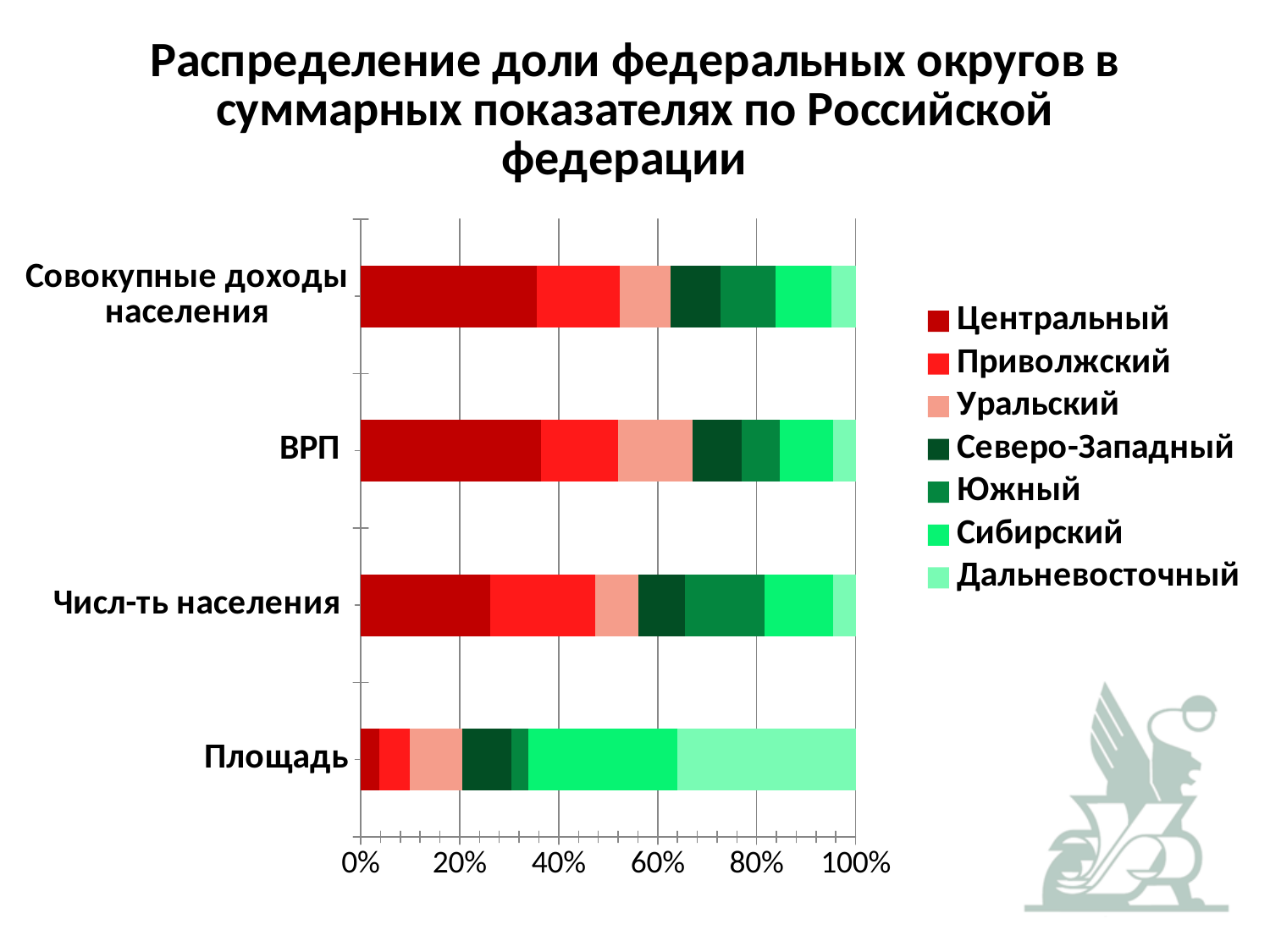
In which category is the Дальневосточный segment the largest? Площадь Which series has the largest segment in the ВРП bar? Центральный Which series has the largest segment in the Площадь bar? Дальневосточный Is the Центральный segment for Площадь greater or less than 20%? less Is the Центральный segment for Совокупные доходы населения greater or less than 20%? greater How many categories are plotted on the vertical axis? 4 Which legend entry is shown in the darkest red colour? Центральный How many series does the legend list? 7 What kind of chart is shown on the slide? Stacked bar chart What is the total of the stacked bar for Площадь? 100% Which legend entry is listed last in the legend? Дальневосточный Which is larger: the Центральный segment for ВРП or the Центральный segment for Площадь? ВРП